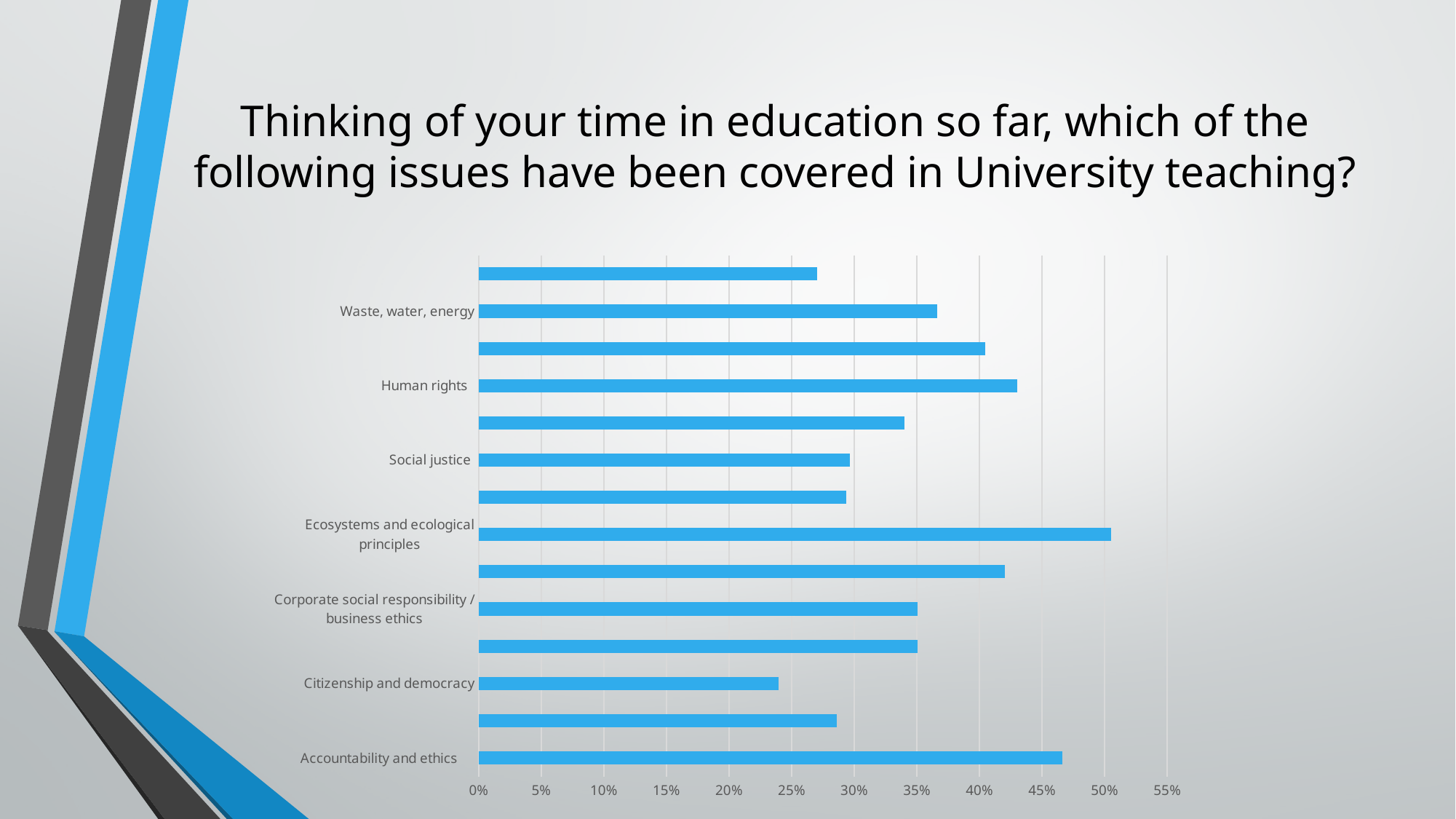
Is the value for Accountability and ethics greater or less than 45%? greater Which is larger, the value for Human rights or the value for Social justice? Human rights How many bars are plotted in the chart? 14 Is the value for Citizenship and democracy greater or less than 25%? less Which is larger, the value for Accountability and ethics or the value for Corporate social responsibility / business ethics? Accountability and ethics Which labelled category has the shortest bar? Citizenship and democracy Is the value for Waste, water, energy greater or less than 35%? greater What kind of chart is shown on the slide? bar chart Which labelled category has the longest bar? Ecosystems and ecological principles